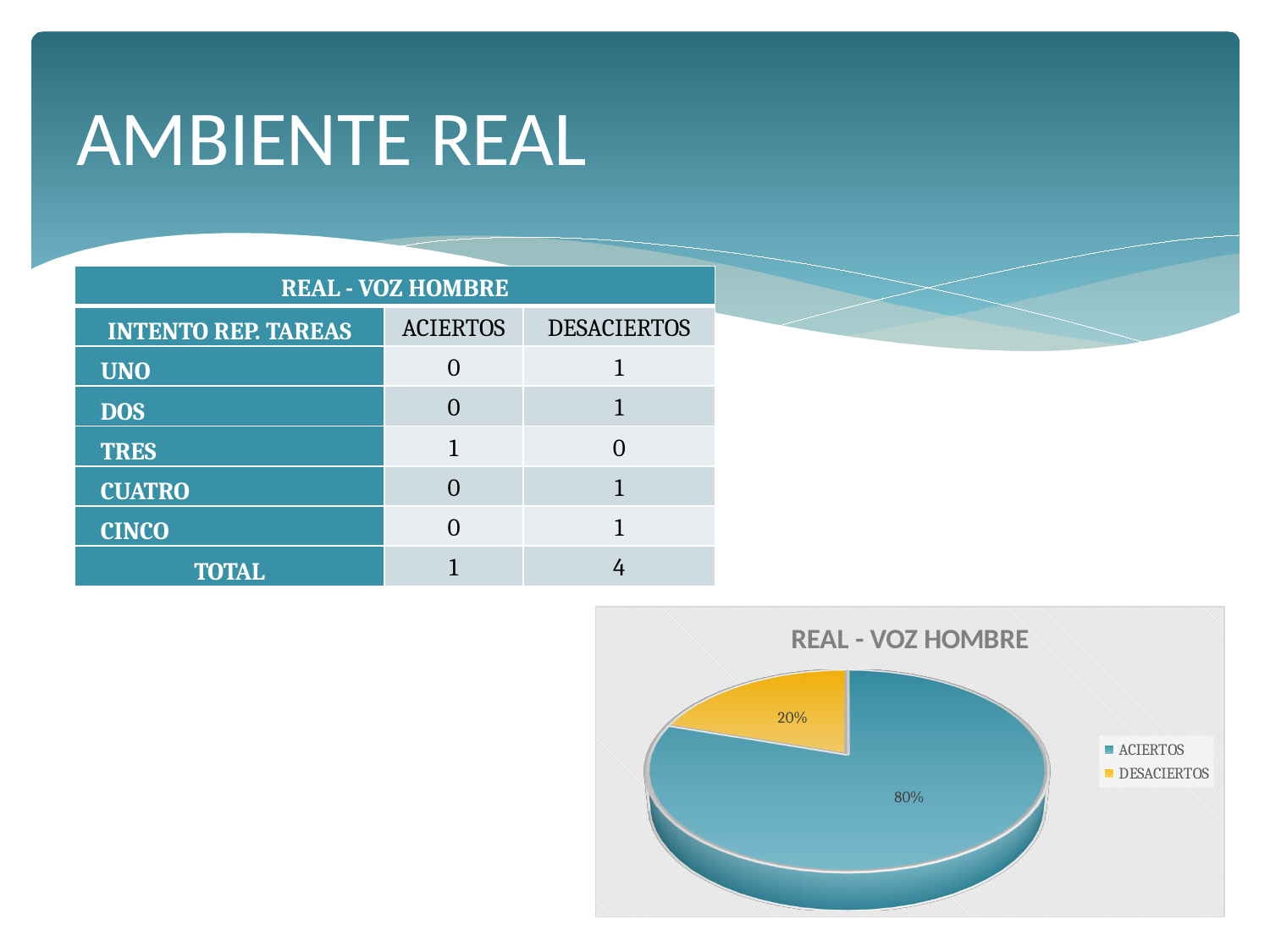
Which slice of the pie chart is the largest? ACIERTOS What share of the pie does the DESACIERTOS slice represent? 20% What percentage does the DESACIERTOS slice show in the pie chart? 20% How many slices does the pie chart have? 2 Which is larger in the pie chart, ACIERTOS or DESACIERTOS? ACIERTOS What colour is the DESACIERTOS slice in the pie chart? yellow Which slice of the pie chart is the smallest? DESACIERTOS What percentage does the ACIERTOS slice show in the pie chart? 80% What is the title of the chart? REAL - VOZ HOMBRE How many entries does the chart legend list? 2 What is the difference in percentage points between the ACIERTOS and DESACIERTOS slices? 60 What kind of chart is shown on the slide? pie chart